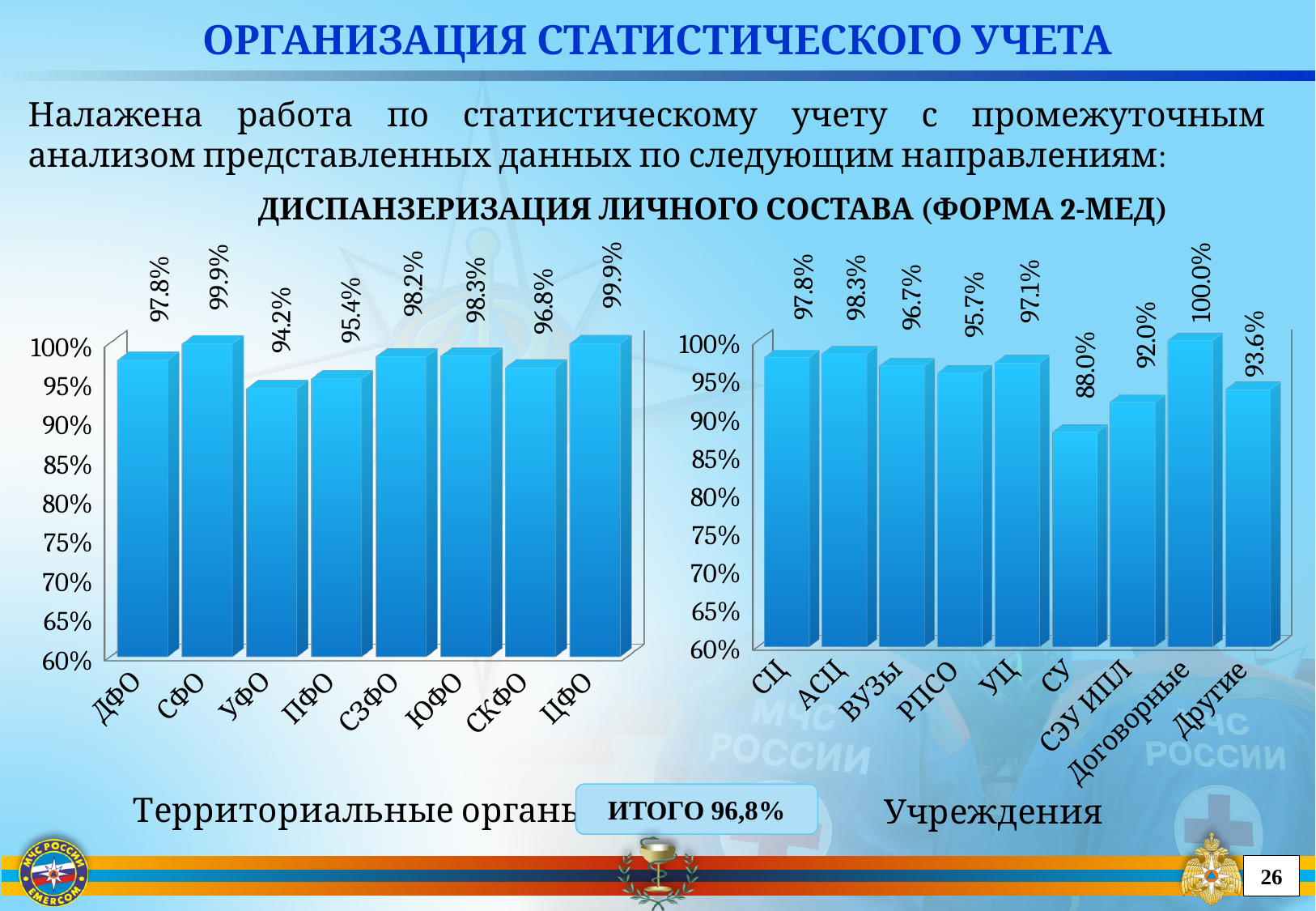
In the left chart (Территориальные органы), which category has the lowest value? УФО In the left chart (Территориальные органы), what is the difference between the values for ЦФО and СКФО? 3.1% In the left chart (Территориальные органы), which is larger, the value for ДФО or the value for ПФО? ДФО In the right chart (Учреждения), what is the value for Другие? 93.6% In the left chart (Территориальные органы), what is the value for УФО? 94.2% What kind of chart is the right chart (Учреждения)? Bar chart In the right chart (Учреждения), what is the difference between the values for АСЦ and СЭУ ИПЛ? 6.3% In the left chart (Территориальные органы), how many categories are shown? 8 In the left chart (Территориальные органы), what is the value for СЗФО? 98.2% In the right chart (Учреждения), which category has the lowest value? СУ In the right chart (Учреждения), which category has the highest value? Договорные In the right chart (Учреждения), what is the value for СУ? 88.0%